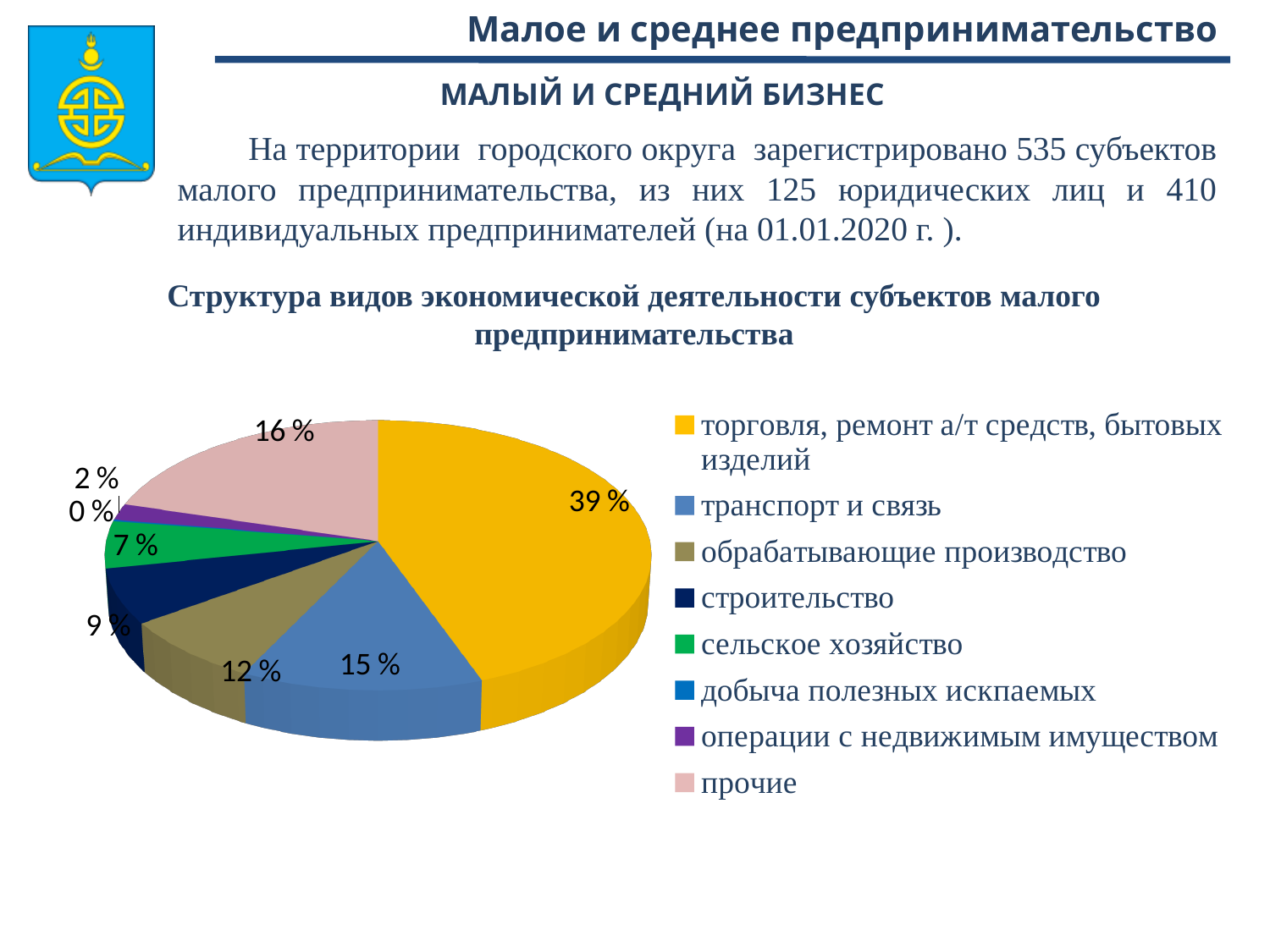
Which is larger: the share for "строительство" or the share for "прочие"? прочие How many categories does the legend list? 8 Which category has the smallest share of the pie? добыча полезных искпаемых What is the difference between the share for "транспорт и связь" and the share for "обрабатывающие производство"? 3 % What share of the pie does "прочие" have? 16 % What is the title of the chart? Структура видов экономической деятельности субъектов малого предпринимательства What share of the pie does "обрабатывающие производство" have? 12 % What kind of chart is shown on the slide? pie chart Which category has the largest share of the pie? торговля, ремонт а/т средств, бытовых изделий What share of the pie does "торговля, ремонт а/т средств, бытовых изделий" have? 39 % What share of the pie does "сельское хозяйство" have? 7 % What share of the pie does "транспорт и связь" have? 15 %